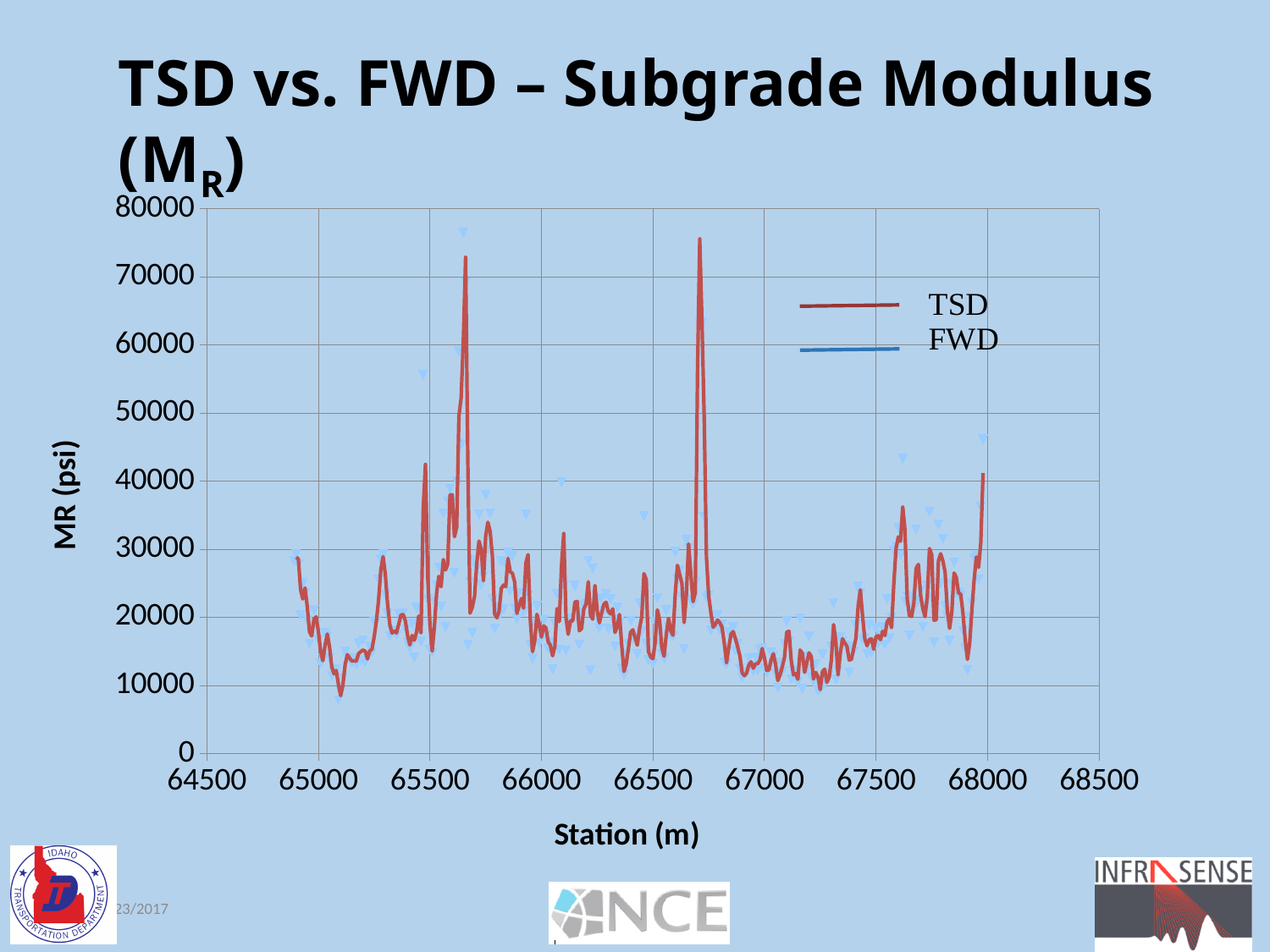
Is the TSD peak near station 66700 greater or less than 70000? greater What is the label of the y axis? MR (psi) Is the highest FWD point, near station 65650, greater or less than 70000? greater What are the two series named in the legend? TSD and FWD How many series does the legend list? 2 Is the TSD peak near station 65650 greater or less than 70000? greater What is the maximum value shown on the y axis? 80000 What kind of chart is shown on the slide? line chart Which is larger for TSD: the peak near station 66700 or the value at station 67000? the peak near station 66700